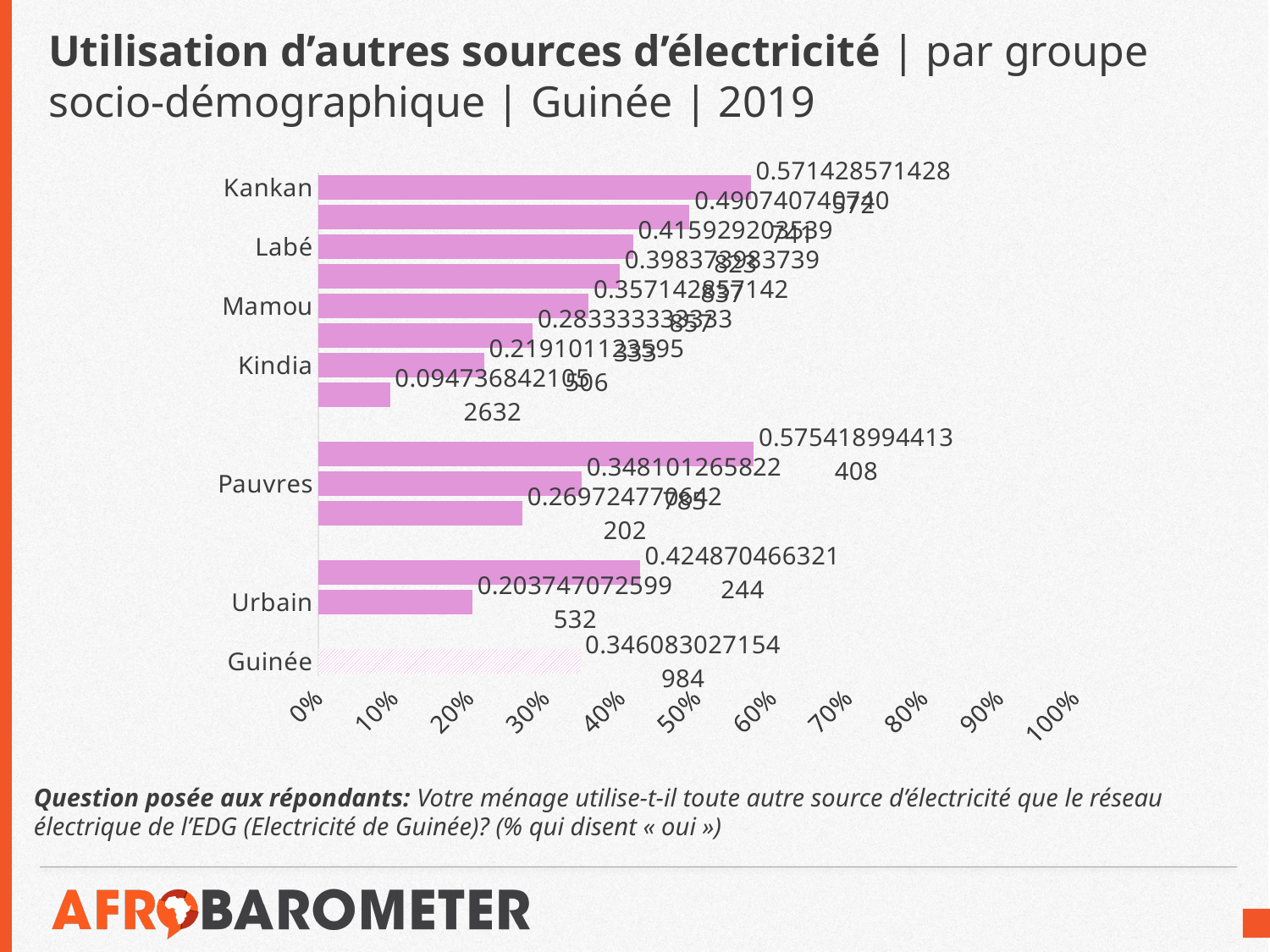
What is the value shown for Pauvres? 0.348101265822 What is the value shown for Kankan? 0.571428571428 What type of chart is shown on the slide? bar chart Which of the labelled categories has the highest value? Kankan Is the value for Kindia greater or less than 30%? less Is the value for Mamou greater or less than 30%? greater How many category labels are shown on the vertical axis? 7 What is the highest value shown on the horizontal axis? 100% Which is larger, the value for Kankan or the value for Kindia? Kankan What is the value shown for Guinée? 0.346083027154 What is the value shown for Urbain? 0.203747072599 Which is larger, the value for Pauvres or the value for Urbain? Pauvres